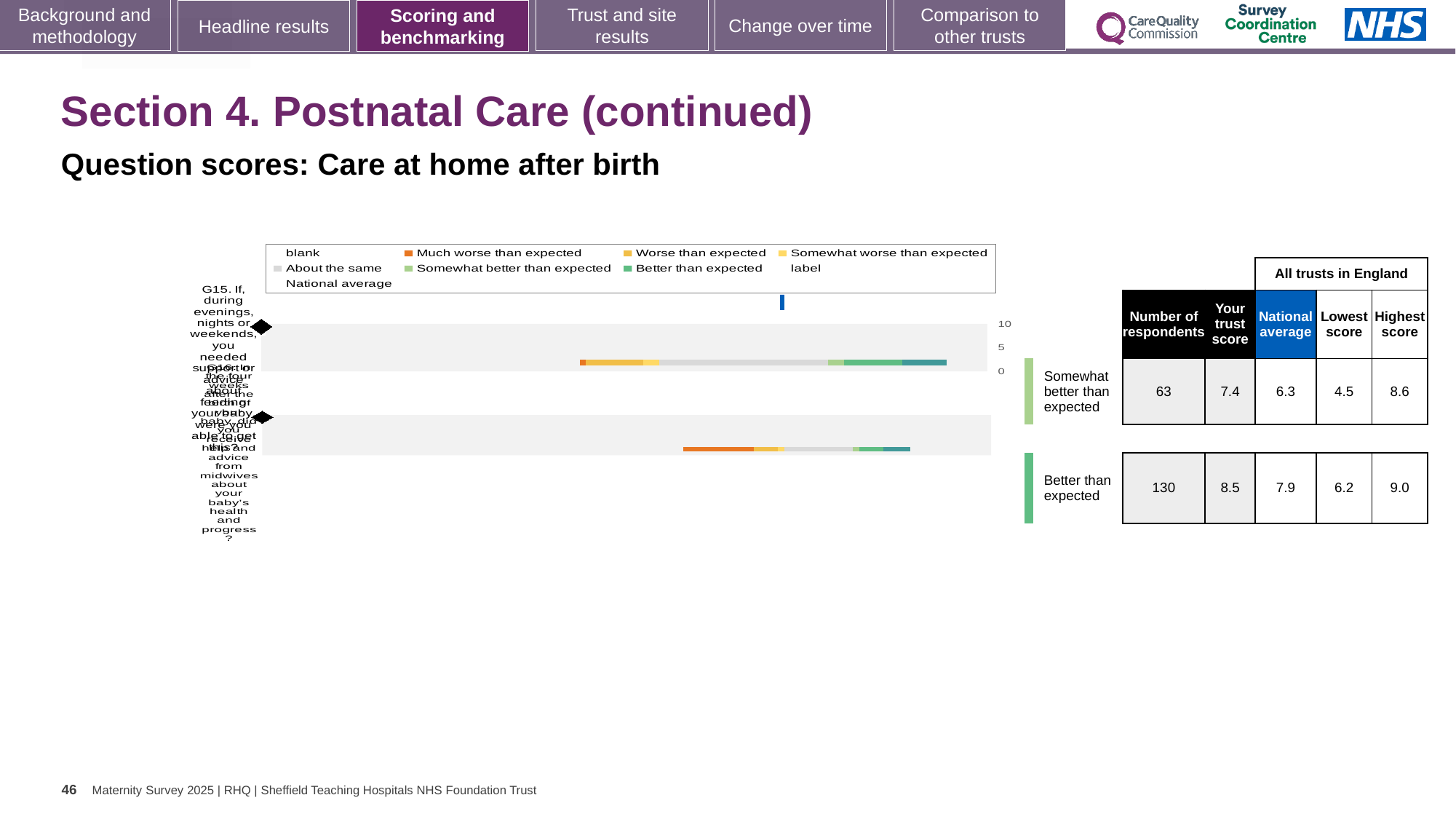
Which question row has the higher 'Your trust score'? Better than expected What is the number of respondents for the question rated 'Somewhat better than expected'? 63 How many question bars are plotted in the chart? 2 What kind of chart is shown on the slide? Bar chart What is the highest score among all trusts in England for the question rated 'Better than expected'? 9.0 What is 'Your trust score' for the question rated 'Better than expected'? 8.5 What is the subtitle describing the question scores shown on the slide? Question scores: Care at home after birth Which of the two questions has more respondents, the one rated 'Somewhat better than expected' or the one rated 'Better than expected'? Better than expected What is the national average for the question rated 'Somewhat better than expected'? 6.3 What is the difference in the number of respondents between the two questions shown? 67 What is the lowest score among all trusts in England for the question rated 'Somewhat better than expected'? 4.5 By how much does the trust score exceed the national average for the question rated 'Better than expected'? 0.6